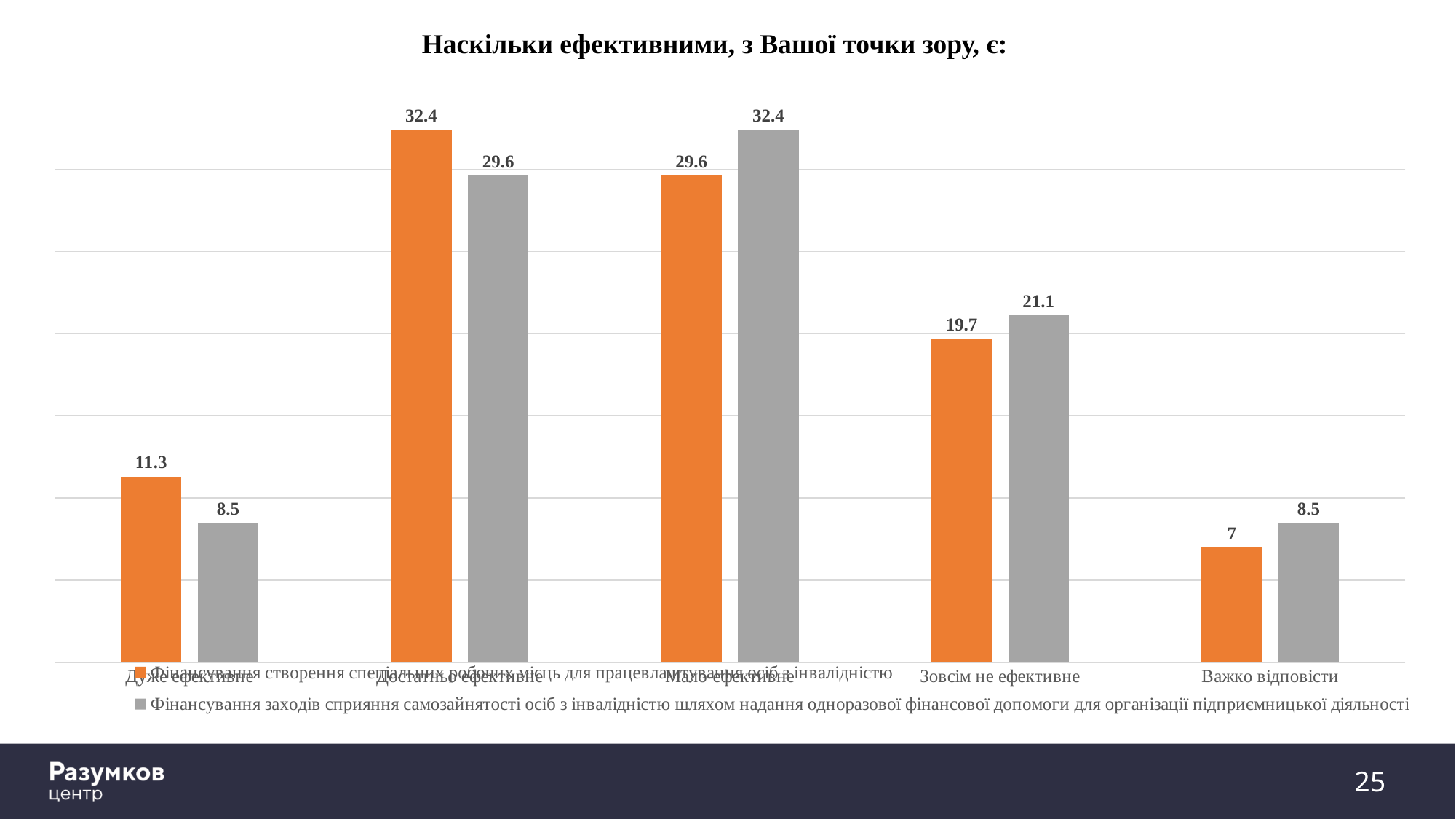
What is the value for 'Зовсім не ефективне' in the series 'Фінансування заходів сприяння самозайнятості осіб з інвалідністю шляхом надання одноразової фінансової допомоги для організації підприємницької діяльності'? 21.1 Which category has the lowest value in the series 'Фінансування створення спеціальних робочих місць для працевлаштування осіб з інвалідністю'? Важко відповісти What is the value for 'Дуже ефективне' in the series 'Фінансування створення спеціальних робочих місць для працевлаштування осіб з інвалідністю'? 11.3 What is the value for 'Важко відповісти' in the series 'Фінансування створення спеціальних робочих місць для працевлаштування осіб з інвалідністю'? 7 What is the difference between the two series for 'Дуже ефективне'? 2.8 Which category has the highest value in the series 'Фінансування заходів сприяння самозайнятості осіб з інвалідністю шляхом надання одноразової фінансової допомоги для організації підприємницької діяльності'? Мало ефективне What colour are the bars for the series 'Фінансування створення спеціальних робочих місць для працевлаштування осіб з інвалідністю'? orange Which category has the highest value in the series 'Фінансування створення спеціальних робочих місць для працевлаштування осіб з інвалідністю'? Достатньо ефективне How many categories are shown on the x axis? 5 How many series does the legend list? 2 What type of chart is shown on the slide? bar chart For 'Зовсім не ефективне', which series has the larger value? Фінансування заходів сприяння самозайнятості осіб з інвалідністю шляхом надання одноразової фінансової допомоги для організації підприємницької діяльності